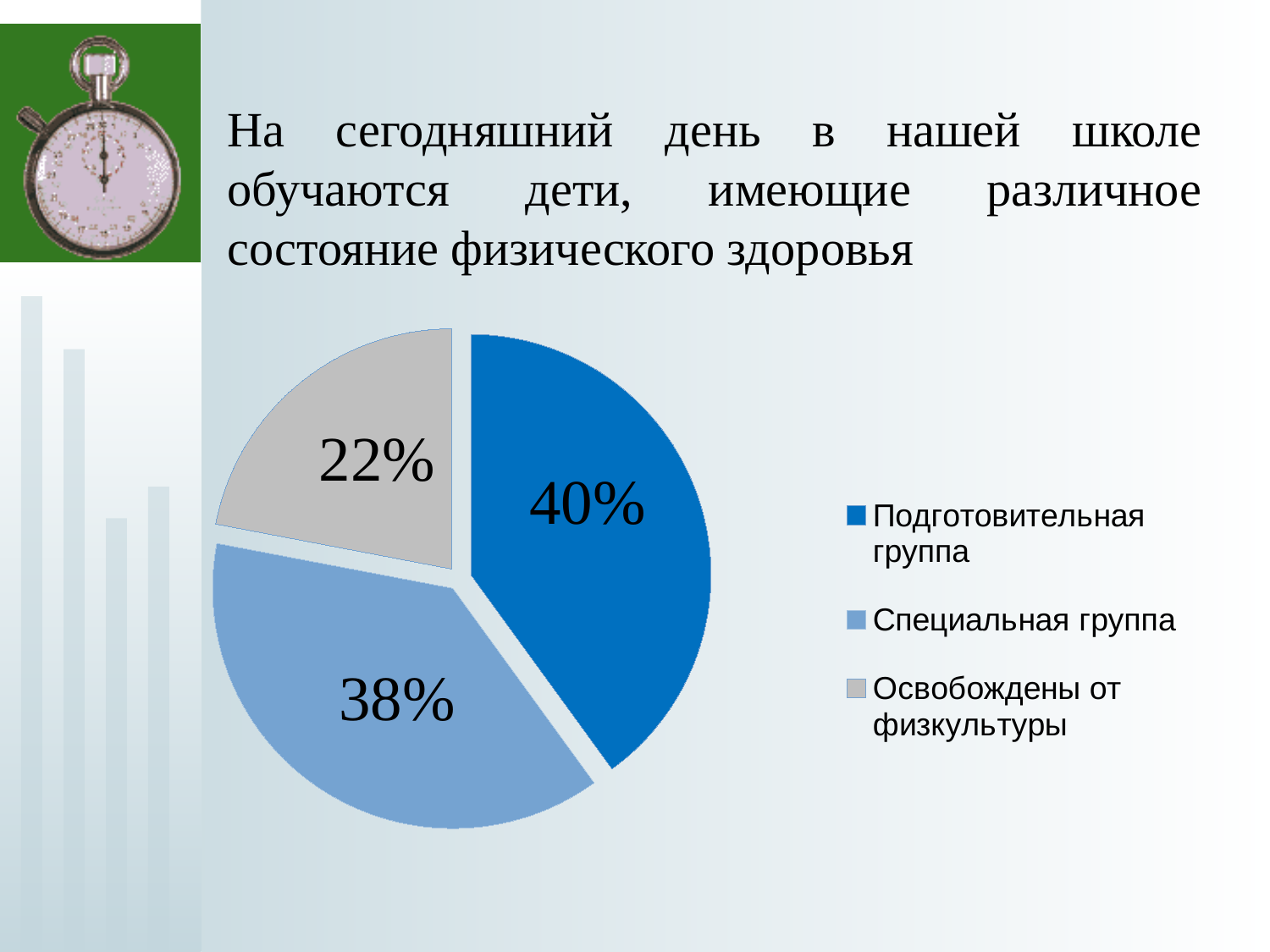
Which is larger: the share of Специальная группа or the share of Освобождены от физкультуры? Специальная группа Which category has the largest slice of the pie? Подготовительная группа Which category has the smallest slice of the pie? Освобождены от физкультуры What colour is the slice for Освобождены от физкультуры? grey What share of the pie does Специальная группа have? 38% What is the difference between the shares of Специальная группа and Освобождены от физкультуры? 16% How many slices does the pie chart have? 3 What share of the pie does Подготовительная группа have? 40% What share of the pie does Освобождены от физкультуры have? 22% How many entries does the legend list? 3 What is the difference between the shares of Подготовительная группа and Специальная группа? 2% What kind of chart is shown on the slide? pie chart